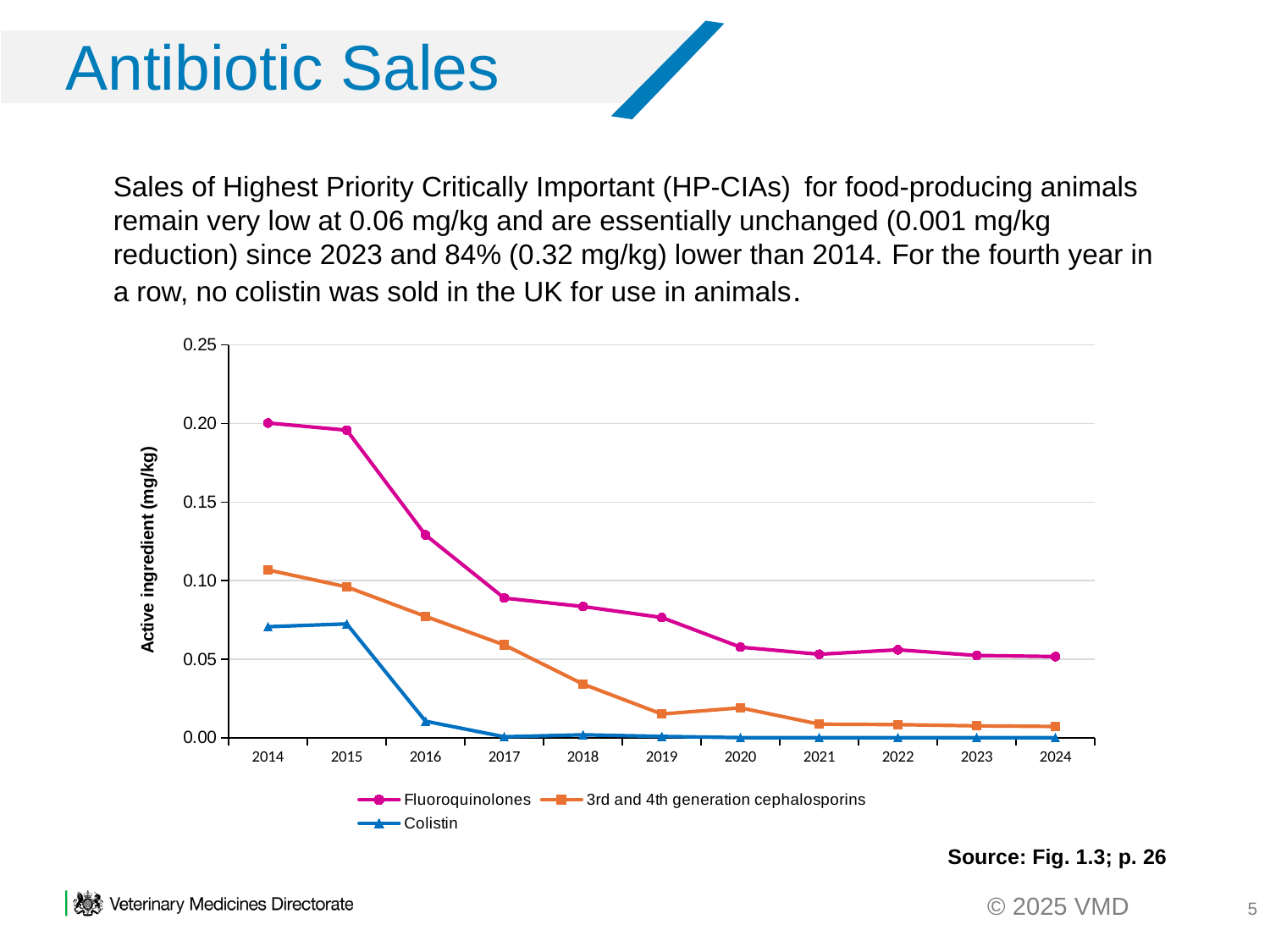
Is the value for Fluoroquinolones in 2016 greater or less than 0.10? greater Is the value for Fluoroquinolones in 2024 greater or less than 0.10? less Which is larger in 2019: Fluoroquinolones or 3rd and 4th generation cephalosporins? Fluoroquinolones Is the value for Colistin in 2015 greater or less than 0.05? greater How many years are plotted along the x axis of the chart? 11 Which series has the lowest value in 2024? Colistin Do the values for Fluoroquinolones generally rise or fall from 2014 to 2024? fall What kind of chart is shown on the slide? line chart What is the label on the y axis of the chart? Active ingredient (mg/kg) How many series does the chart legend list? 3 Which series has the highest value in 2014? Fluoroquinolones